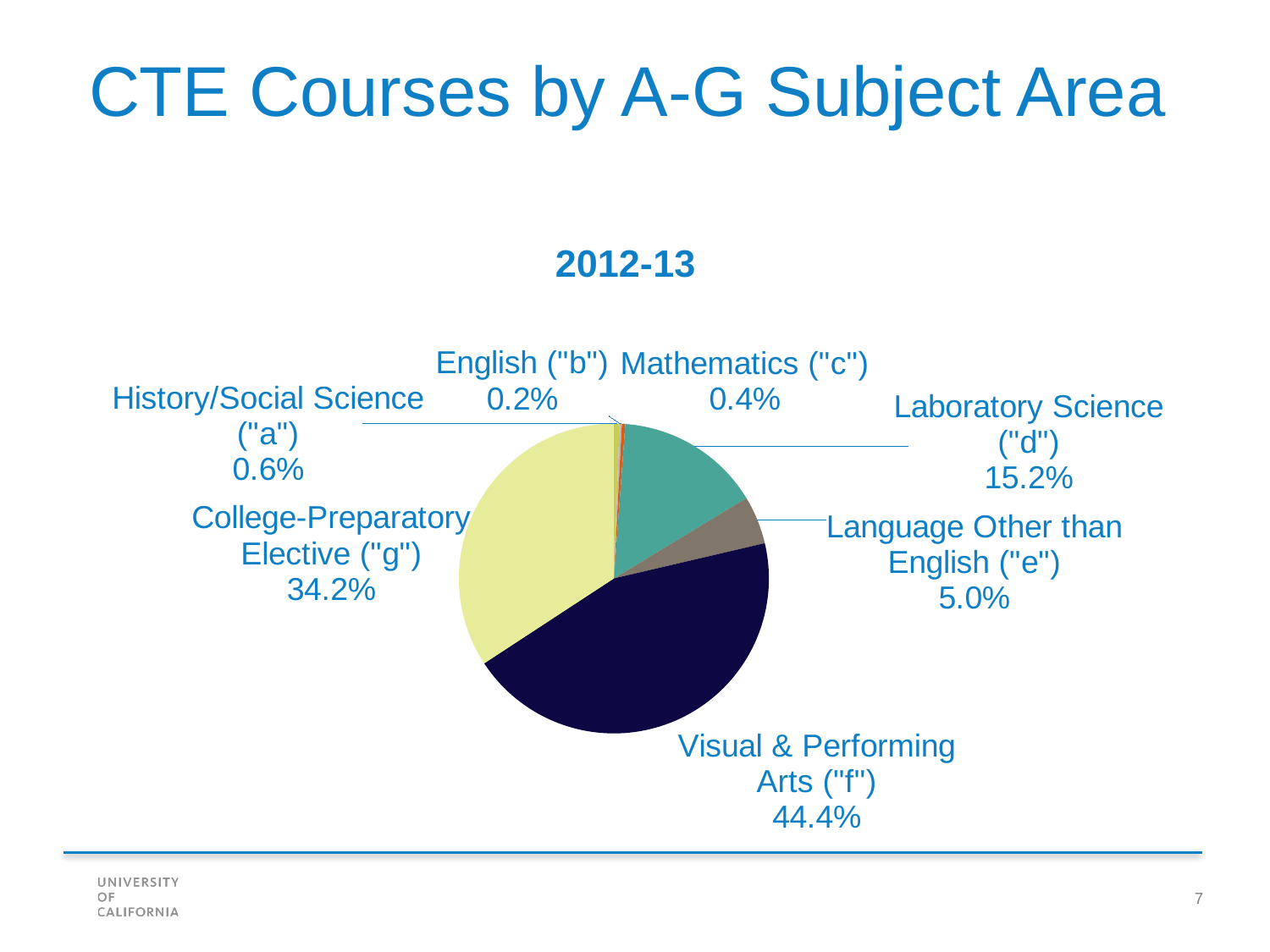
How many subject areas are shown in the pie chart? 7 What share of CTE courses is Visual & Performing Arts ("f")? 44.4% Which subject area has the smallest share of CTE courses? English ("b") Which has a larger share, Laboratory Science ("d") or Language Other than English ("e")? Laboratory Science ("d") What share of CTE courses is History/Social Science ("a")? 0.6% What share of CTE courses is College-Preparatory Elective ("g")? 34.2% What share of CTE courses is Laboratory Science ("d")? 15.2% Which subject area has the largest share of CTE courses? Visual & Performing Arts ("f") What school year does the chart cover? 2012-13 What is the difference in percentage points between Visual & Performing Arts ("f") and College-Preparatory Elective ("g")? 10.2 What share of CTE courses is Language Other than English ("e")? 5.0% What kind of chart is shown on the slide? Pie chart